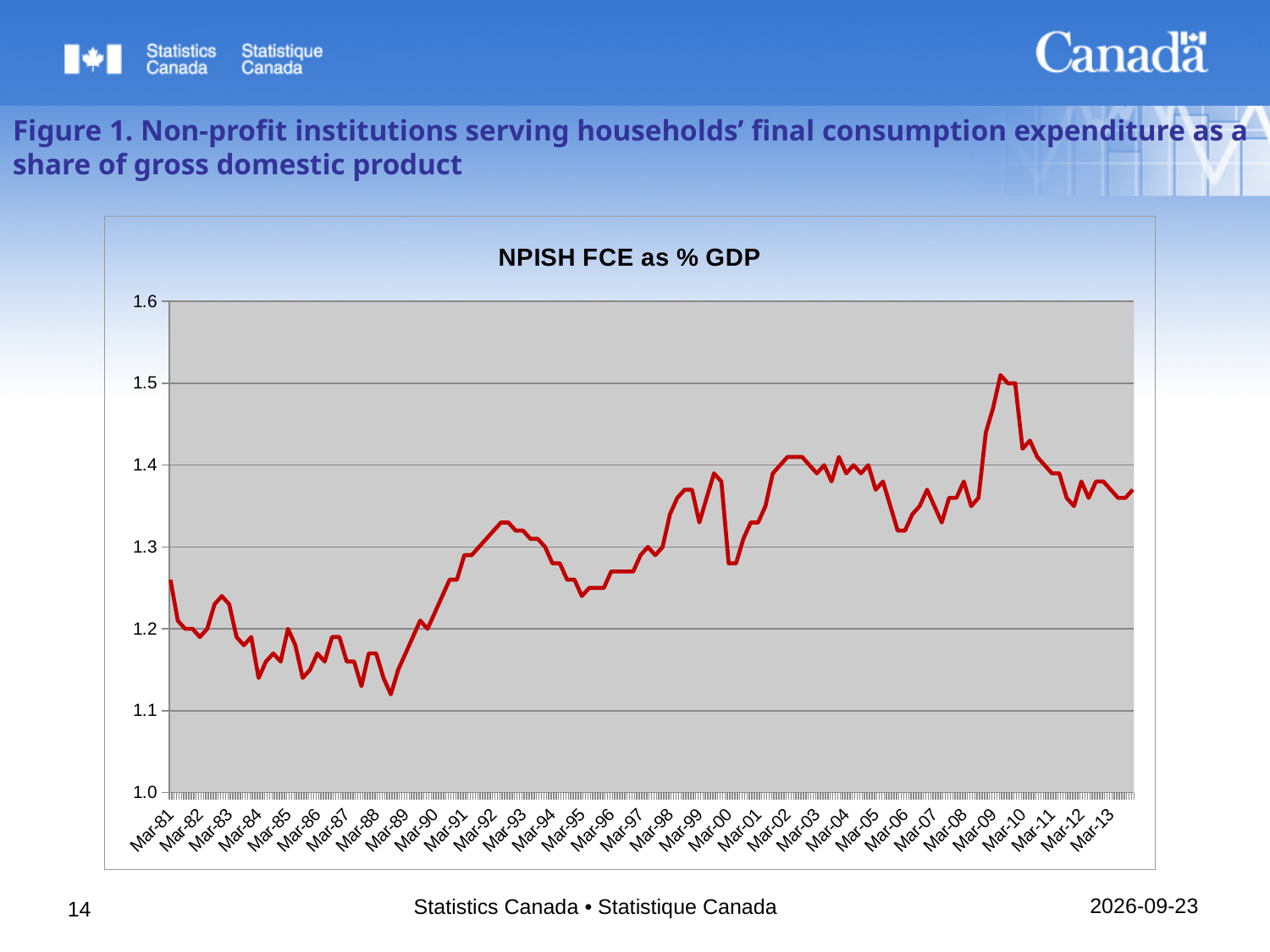
How many lines (series) are plotted on the chart? 1 Does the line generally rise or fall between Mar-81 and Mar-89? fall What is the title of the chart? NPISH FCE as % GDP What kind of chart is shown on the slide? line chart Is the peak value around Mar-09 greater or less than 1.4? greater How many date labels are shown along the x axis, from Mar-81 to Mar-13? 33 Is the value at Mar-81 greater or less than 1.2? greater What colour is the plotted line? red Is the value at Mar-89 greater or less than 1.2? less Which is larger, the value at Mar-13 or the value at Mar-81? Mar-13 Around which x-axis label does the line reach its highest value? Mar-09